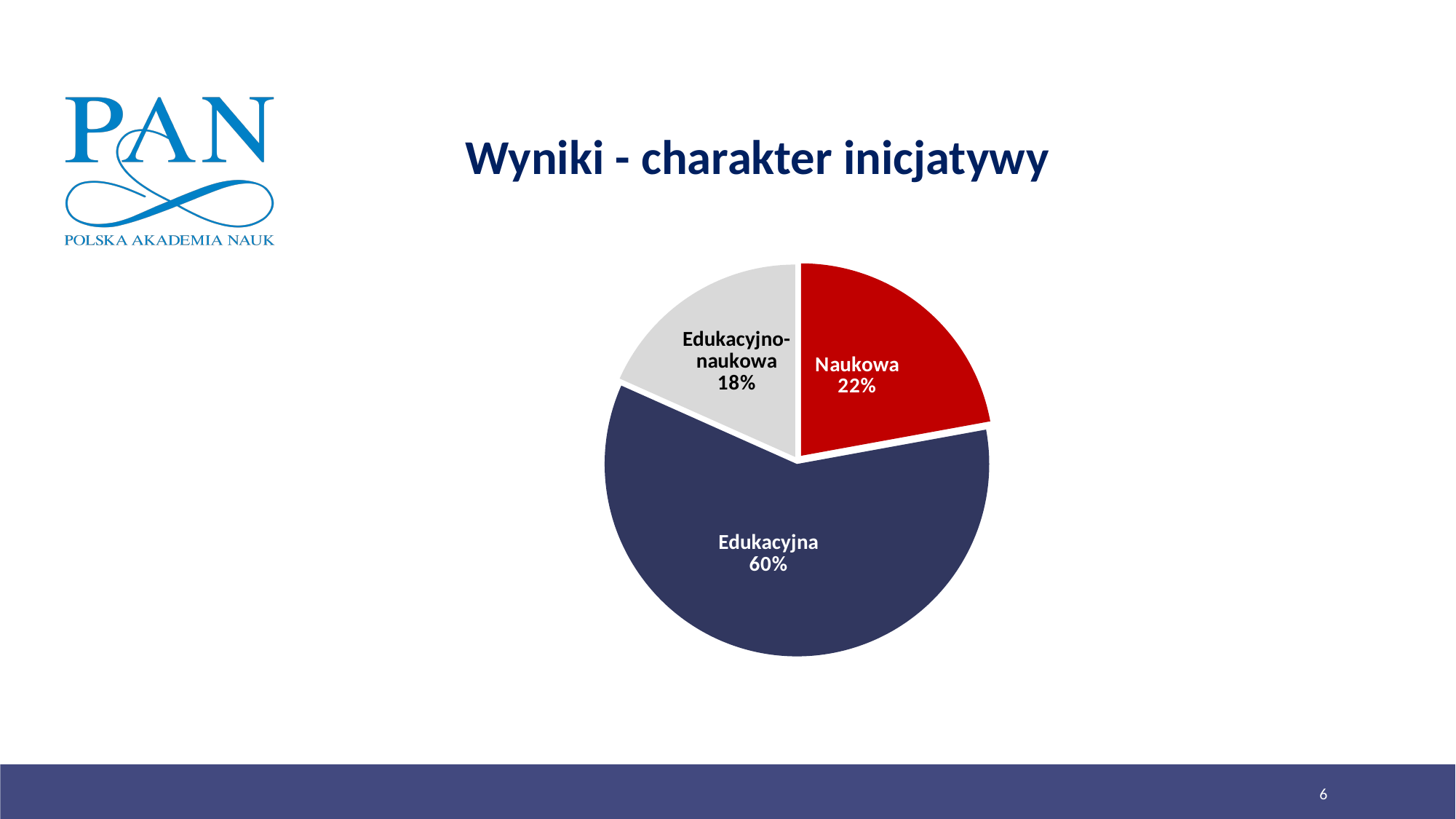
What kind of chart is shown on the slide? Pie chart What share of the pie does Edukacyjno-naukowa represent? 18% What share of the pie does Naukowa represent? 22% Which is larger, the Naukowa slice or the Edukacyjno-naukowa slice? Naukowa What is the difference in percentage points between Edukacyjna and Naukowa? 38 Which category has the smallest slice of the pie? Edukacyjno-naukowa How many categories are shown in the pie chart? 3 What colour is the Naukowa slice? Red What share of the pie does Edukacyjna represent? 60% What is the difference in percentage points between Naukowa and Edukacyjno-naukowa? 4 What is the title of the slide containing the chart? Wyniki - charakter inicjatywy Which category has the largest slice of the pie? Edukacyjna